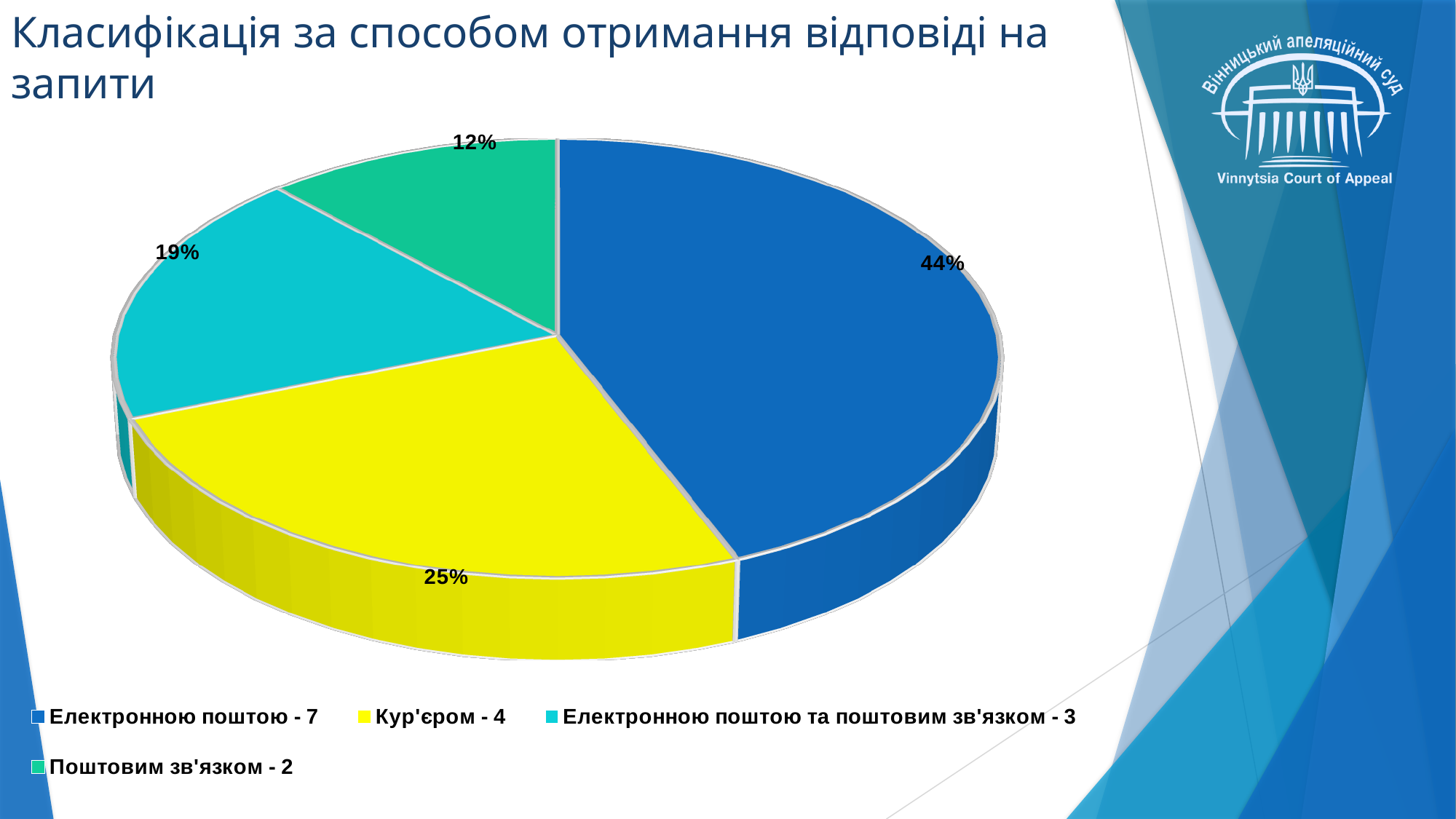
Which slice is larger: "Кур'єром" or "Поштовим зв'язком"? Кур'єром How many entries does the legend list? 4 What percentage share is shown for the slice "Кур'єром - 4"? 25% What percentage share is shown for the slice "Електронною поштою та поштовим зв'язком - 3"? 19% Which category has the largest slice of the pie? Електронною поштою - 7 What is the title of the slide containing the chart? Класифікація за способом отримання відповіді на запити What kind of chart is shown on the slide? Pie chart What is the difference in percentage points between the "Електронною поштою" slice and the "Кур'єром" slice? 19 percentage points What percentage share is shown for the slice "Поштовим зв'язком - 2"? 12% How many slices does the pie chart have? 4 Which category has the smallest slice of the pie? Поштовим зв'язком - 2